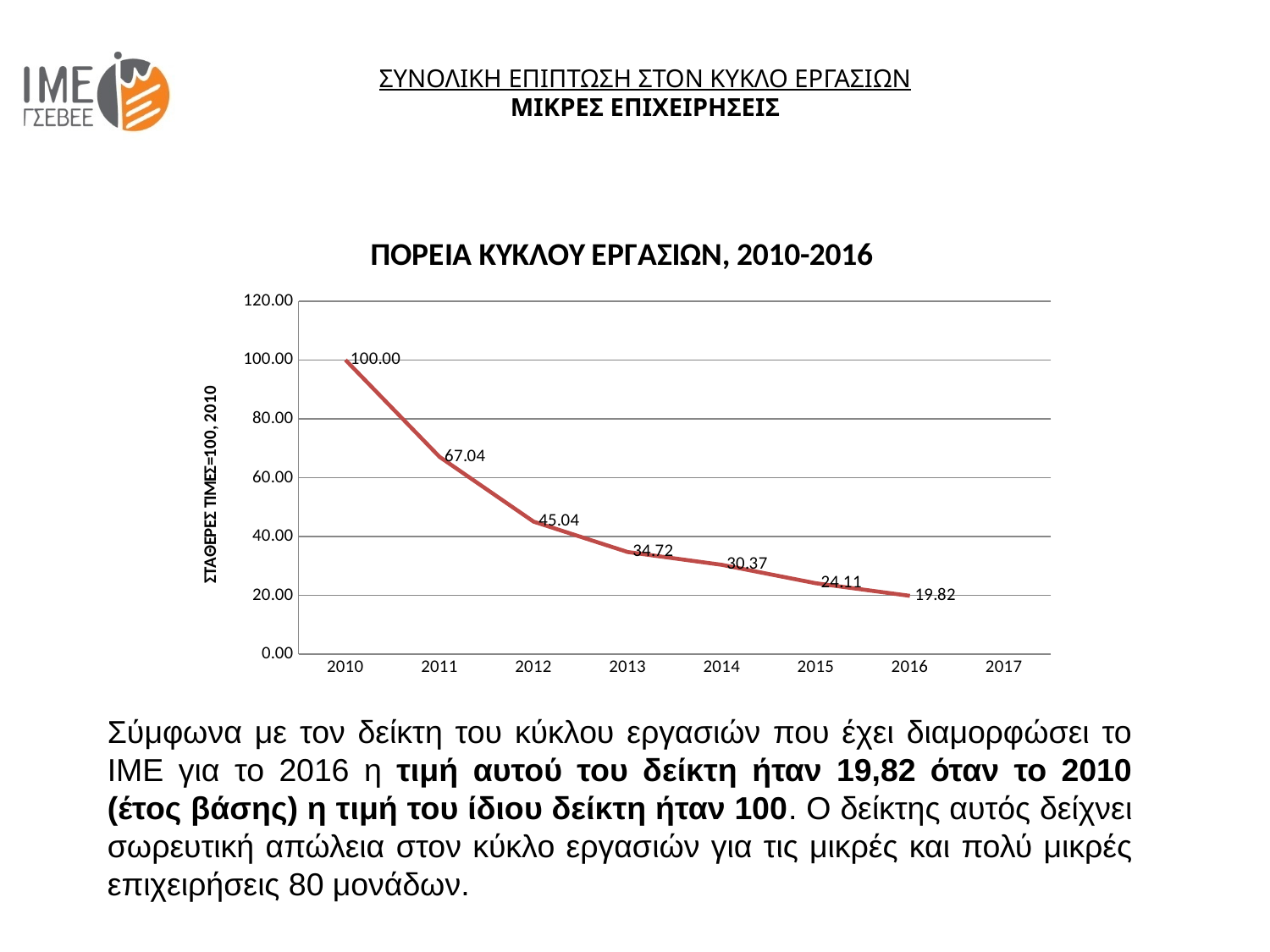
What is the value for 2016 in the chart? 19.82 Do the values rise or fall from 2010 to 2016? Fall What is the value for 2011 in the chart? 67.04 Which year has the lowest value in the chart? 2016 What is the difference between the values for 2010 and 2016? 80.18 Which year has the highest value in the chart? 2010 What kind of chart is shown on the slide? Line chart How many data points are plotted on the line? 7 What is the value for 2013 in the chart? 34.72 Which is larger, the value for 2014 or the value for 2015? 2014 What is the difference between the values for 2011 and 2012? 22.00 What is the value for 2010 in the chart? 100.00